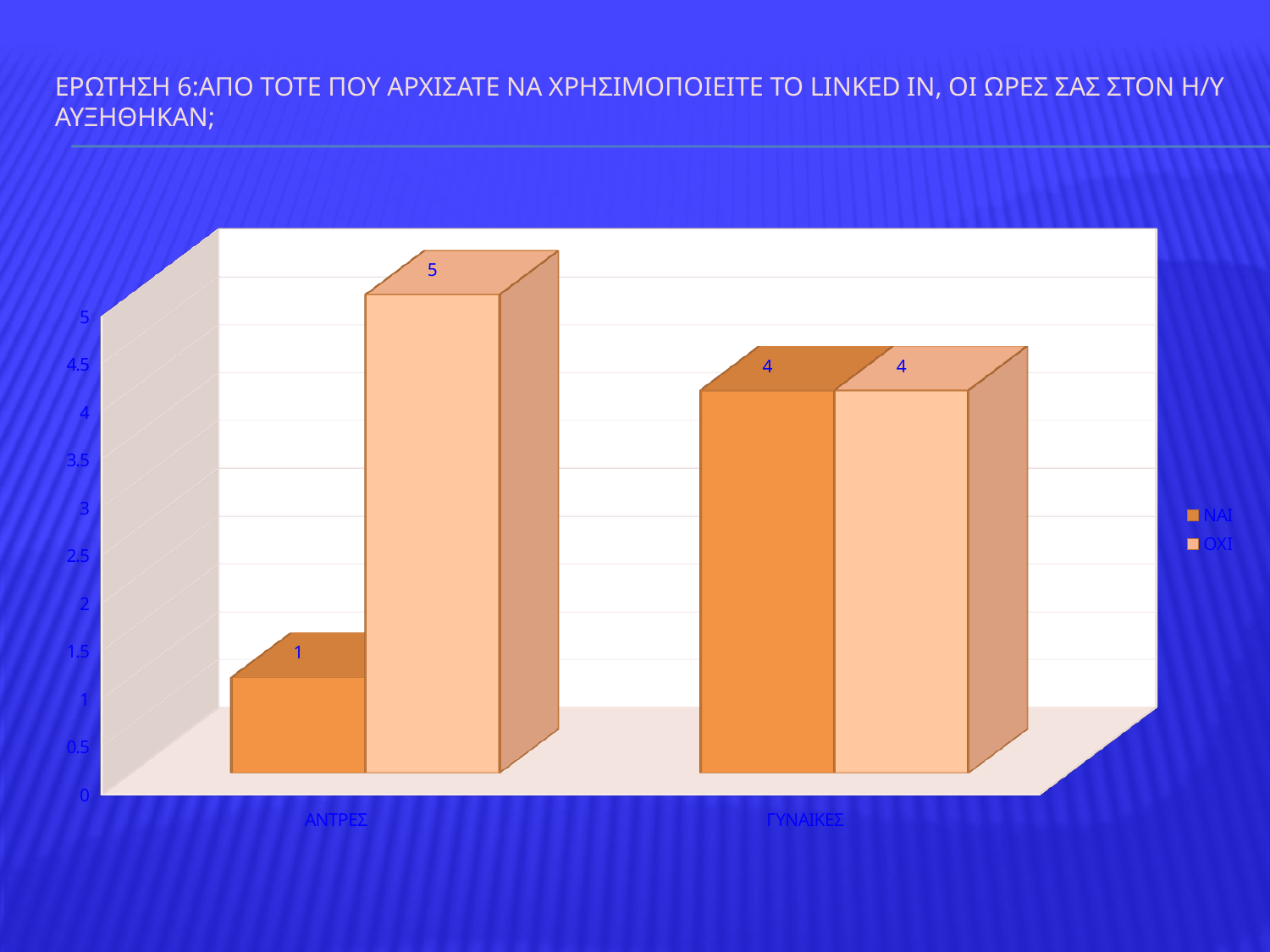
What is the value for ΝΑΙ in the ΑΝΤΡΕΣ category? 1 How many categories are shown on the x axis? 2 What is the value for ΟΧΙ in the ΑΝΤΡΕΣ category? 5 What kind of chart is shown on the slide? Bar chart What is the value for ΝΑΙ in the ΓΥΝΑΙΚΕΣ category? 4 What are the two entries in the chart legend? ΝΑΙ and ΟΧΙ Which bar has the highest value on the chart? ΟΧΙ for ΑΝΤΡΕΣ How many series does the legend list? 2 Which is larger for ΑΝΤΡΕΣ, the ΝΑΙ value or the ΟΧΙ value? ΟΧΙ Which bar has the lowest value on the chart? ΝΑΙ for ΑΝΤΡΕΣ What is the value for ΟΧΙ in the ΓΥΝΑΙΚΕΣ category? 4 What is the difference between the ΟΧΙ and ΝΑΙ values for ΑΝΤΡΕΣ? 4